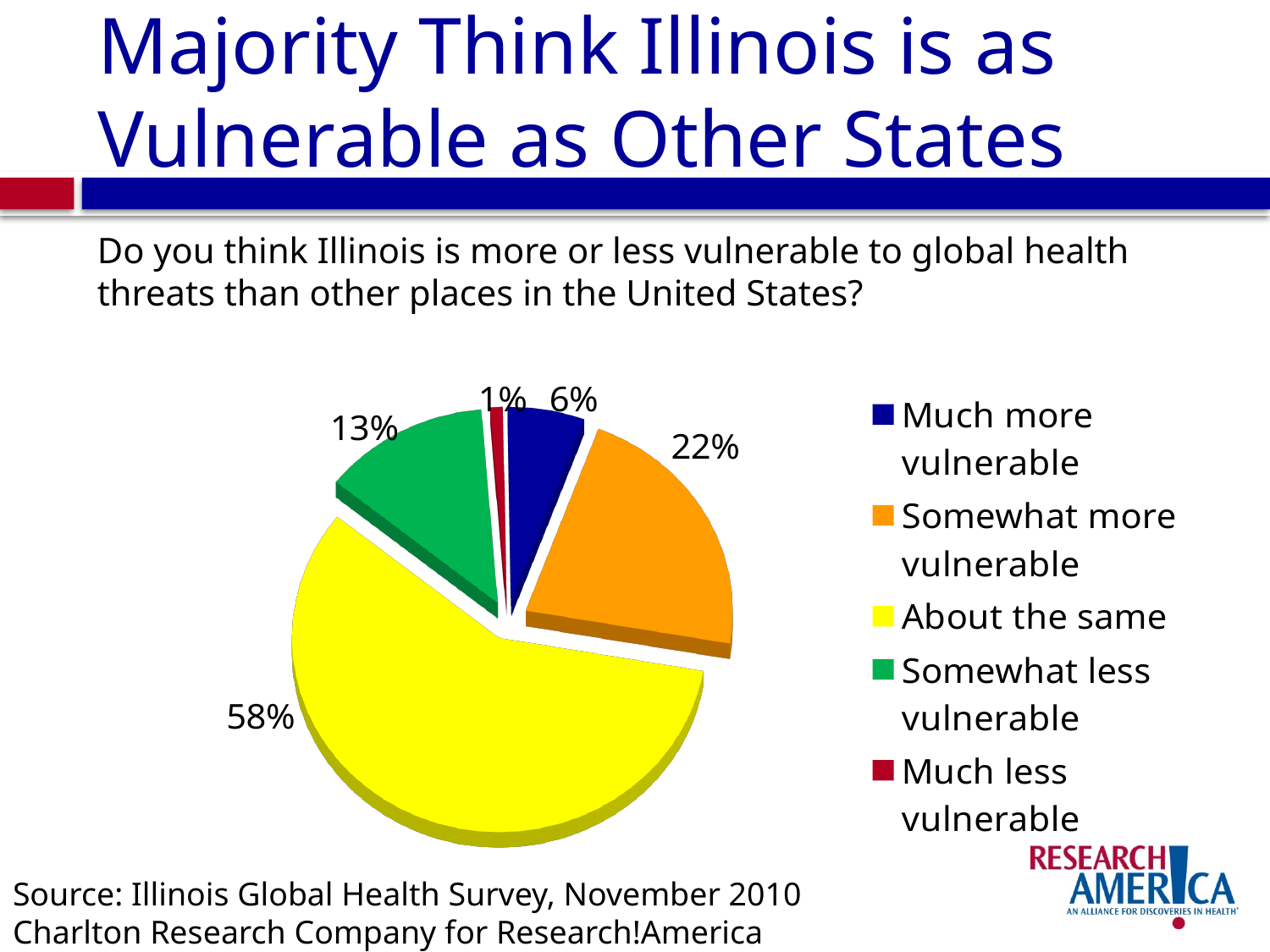
What percentage of respondents said Illinois is much more vulnerable? 6% Which is larger: the share for 'Much more vulnerable' or the share for 'Somewhat less vulnerable'? Somewhat less vulnerable Which response category has the smallest share of the pie? Much less vulnerable What percentage of respondents said Illinois is somewhat less vulnerable? 13% What type of chart is shown on the slide? Pie chart How many response categories are shown in the pie chart? 5 Which response category has the largest share of the pie? About the same What is the difference in percentage points between 'Somewhat more vulnerable' and 'Somewhat less vulnerable'? 9 What percentage of respondents said Illinois is somewhat more vulnerable? 22% What percentage of respondents said Illinois is much less vulnerable? 1% What percentage of respondents said Illinois is about the same in vulnerability as other places? 58% What colour is the slice for 'About the same'? Yellow